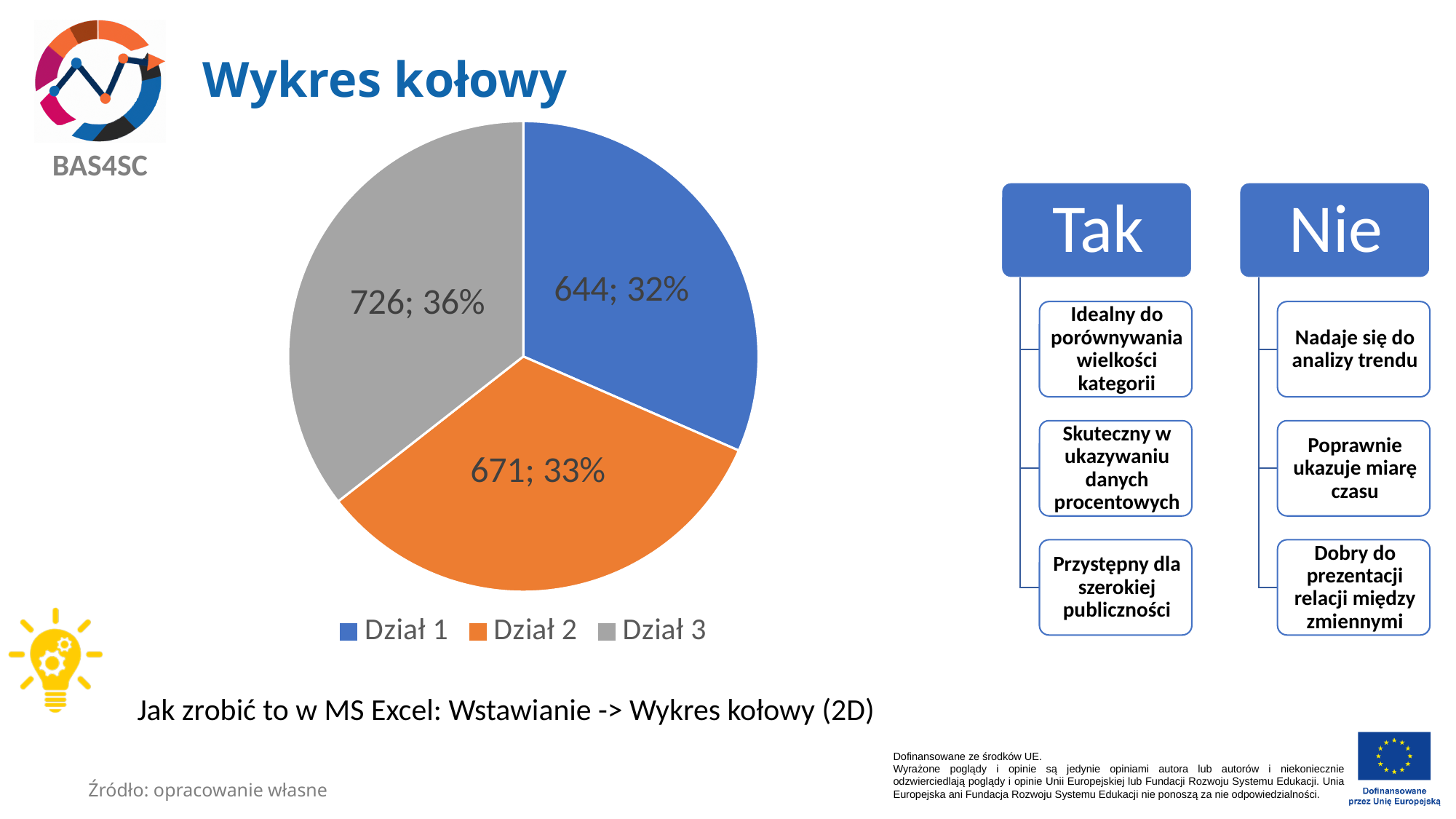
Which category has the largest slice? Dział 3 What is the value for Dział 3? 726 What is the value for Dział 1? 644 How many categories does the pie chart have? 3 What percentage share does Dział 3 have? 36% What is the value for Dział 2? 671 What percentage share does Dział 1 have? 32% What kind of chart is shown on the slide? pie chart What is the difference between the values for Dział 3 and Dział 1? 82 What colour is the slice for Dział 2? orange Which category has the smallest slice? Dział 1 Which is larger, the value for Dział 2 or Dział 1? Dział 2